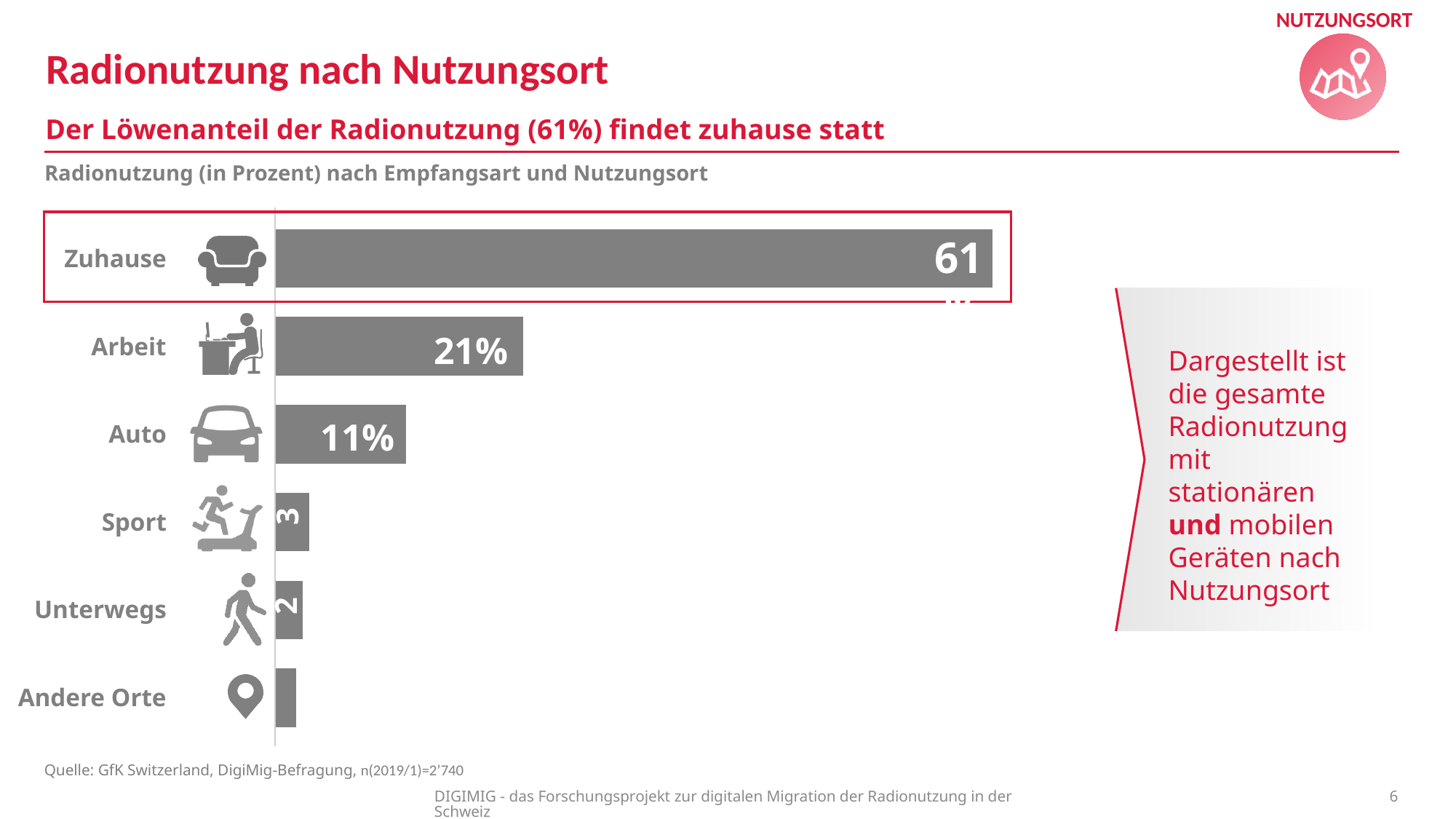
What kind of chart is shown on the slide? bar chart What is the difference between the values for Arbeit and Auto? 10 percentage points What is the value for Sport? 3 Which category has the lowest value? Andere Orte Which is larger, the value for Auto or the value for Sport? Auto What share of radio usage takes place at home (Zuhause)? 61% What is the value for Arbeit? 21% How many categories (Nutzungsorte) are shown in the chart? 6 What is the value for Unterwegs? 2 What is the value for Auto? 11% Which category is highlighted with a red frame in the chart? Zuhause Which category has the highest value? Zuhause